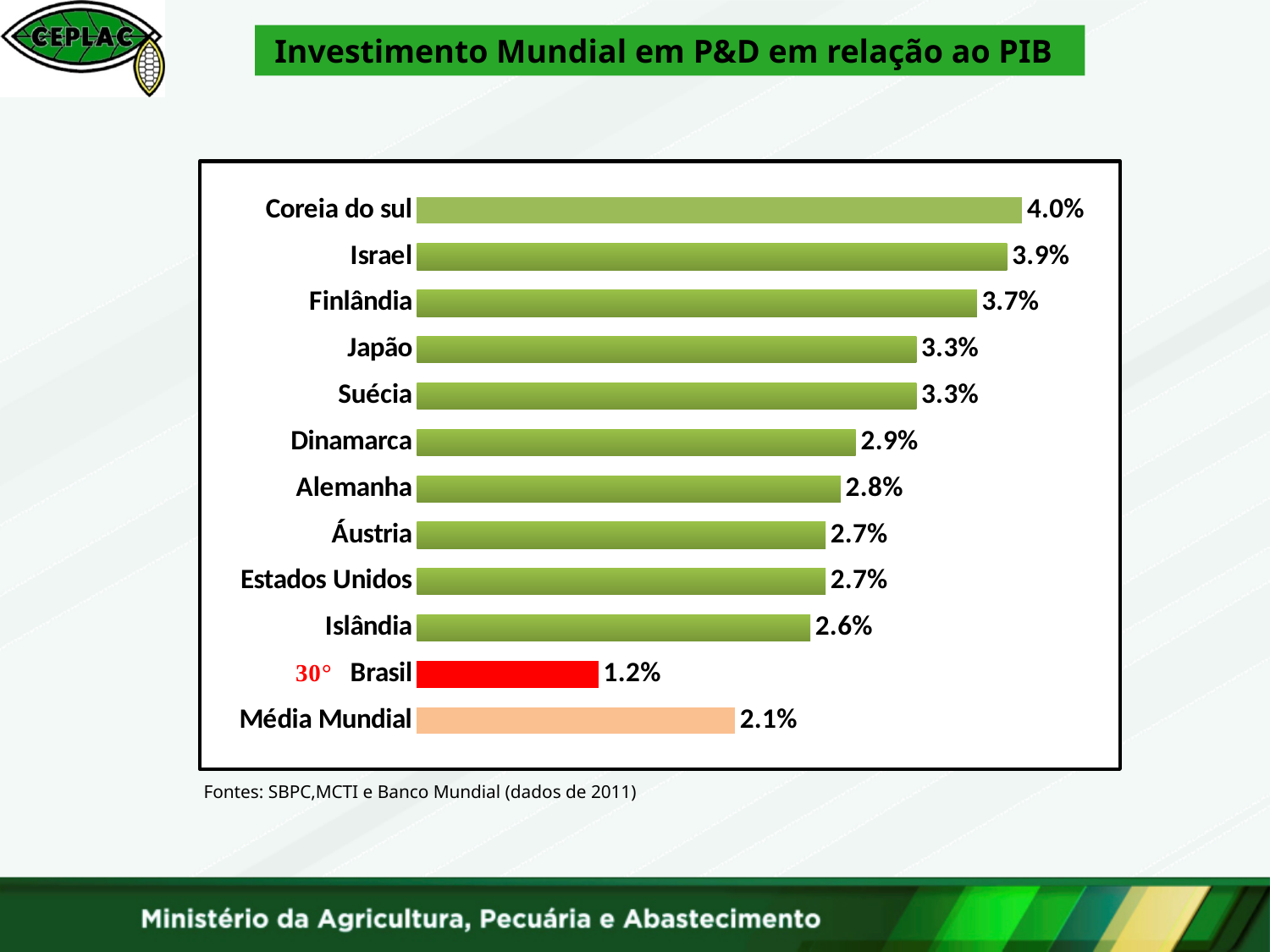
What is the difference between the values for Média Mundial and Brasil? 0.9% Which category has the lowest value? Brasil What is the value for Coreia do sul? 4.0% How many bars are shown in the chart? 12 Which category has the highest value? Coreia do sul What is the value for Dinamarca? 2.9% What is the value for Média Mundial? 2.1% What is the title of the chart? Investimento Mundial em P&D em relação ao PIB What is the value for Brasil? 1.2% What is the difference between the values for Coreia do sul and Brasil? 2.8% Which is larger, the value for Israel or the value for Finlândia? Israel What kind of chart is shown on the slide? Bar chart